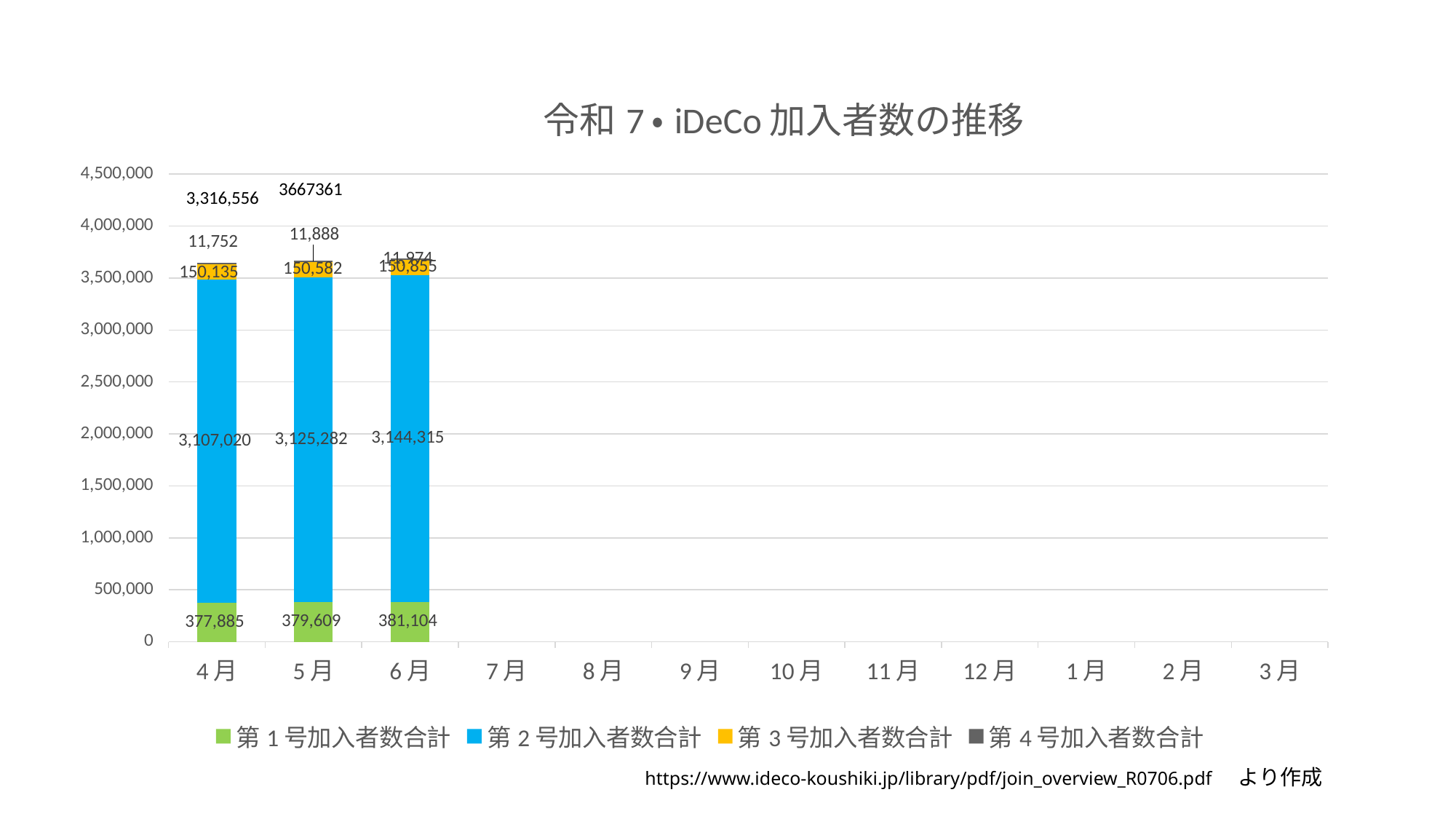
What kind of chart is shown on the slide? stacked bar chart What is the value of 第1号加入者数合計 for 4月? 377,885 Does 第2号加入者数合計 rise or fall from 4月 to 6月? rises What is the value of 第3号加入者数合計 for 6月? 150,855 What is the value of 第2号加入者数合計 for 6月? 3,144,315 What is the value of 第4号加入者数合計 for 5月? 11,888 How many months on the x axis have data plotted? 3 How many series does the legend list? 4 By how much did 第2号加入者数合計 increase from 4月 to 6月? 37,295 Which month has the larger 第3号加入者数合計, 5月 or 6月? 6月 What is the difference in 第1号加入者数合計 between 5月 and 4月? 1,724 Which series is the largest segment of the 6月 bar? 第2号加入者数合計